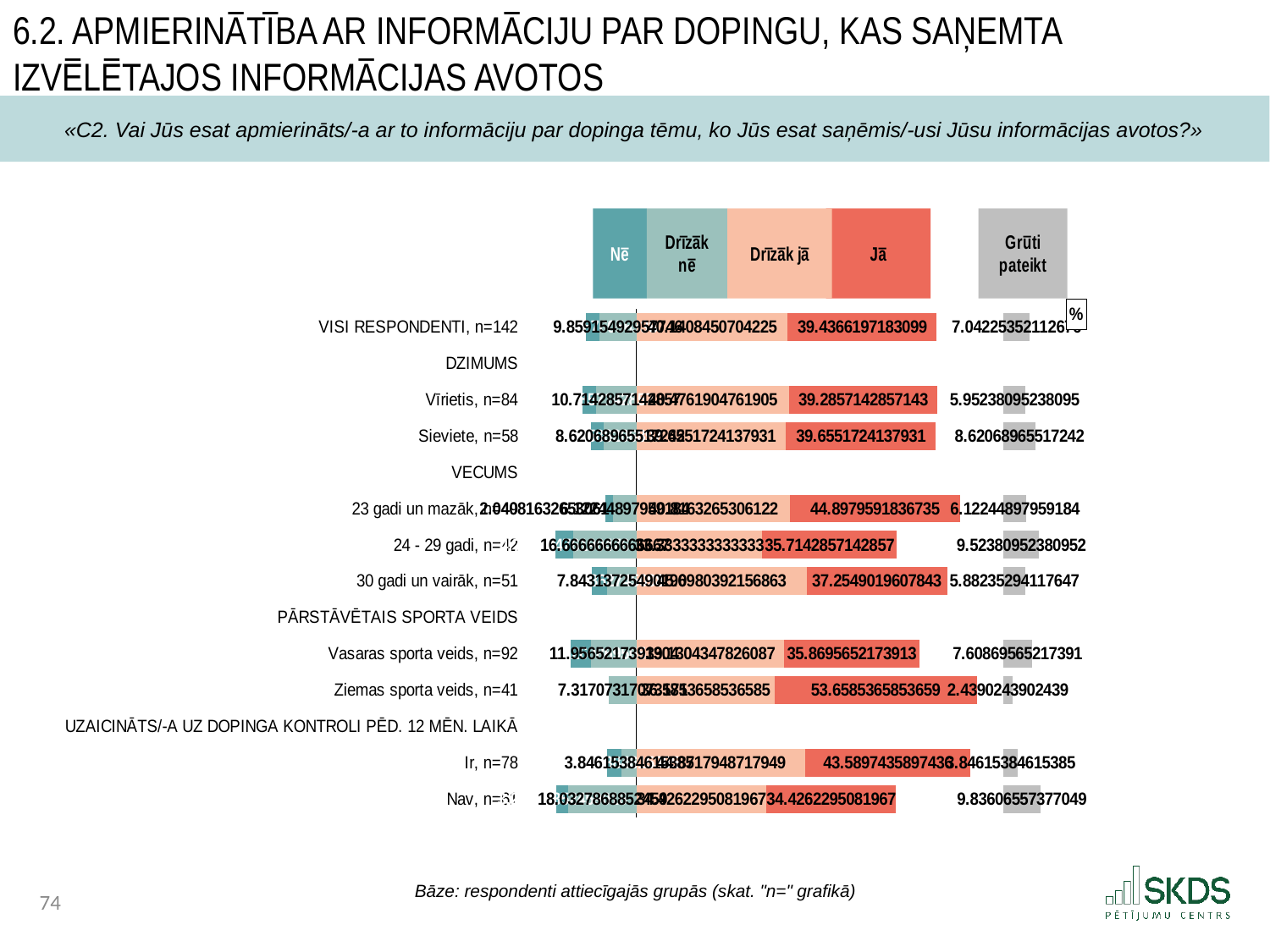
Which group has the lowest "Grūti pateikt" value? Ziemas sporta veids, n=41 What is the value of the "Jā" segment for "VISI RESPONDENTI, n=142"? 39.4366197183099 How many respondent groups have bars plotted in the chart? 10 How many series does the legend list? 5 What is the value of the "Grūti pateikt" segment for "Sieviete, n=58"? 8.62068965517242 What kind of chart is shown on the slide? Stacked bar chart Which group has the highest "Jā" value? Ziemas sporta veids, n=41 What is the value of the "Jā" segment for "Ziemas sporta veids, n=41"? 53.6585365853659 What is the value of the "Jā" segment for "23 gadi un mazāk"? 44.8979591836735 Which has a larger "Jā" value: "Vasaras sporta veids, n=92" or "Ziemas sporta veids, n=41"? Ziemas sporta veids, n=41 What is the difference between the "Grūti pateikt" values for "Sieviete, n=58" and "Vīrietis, n=84"? 2.66830870279147 What is the value of the "Grūti pateikt" segment for "Nav, n=61"? 9.83606557377049